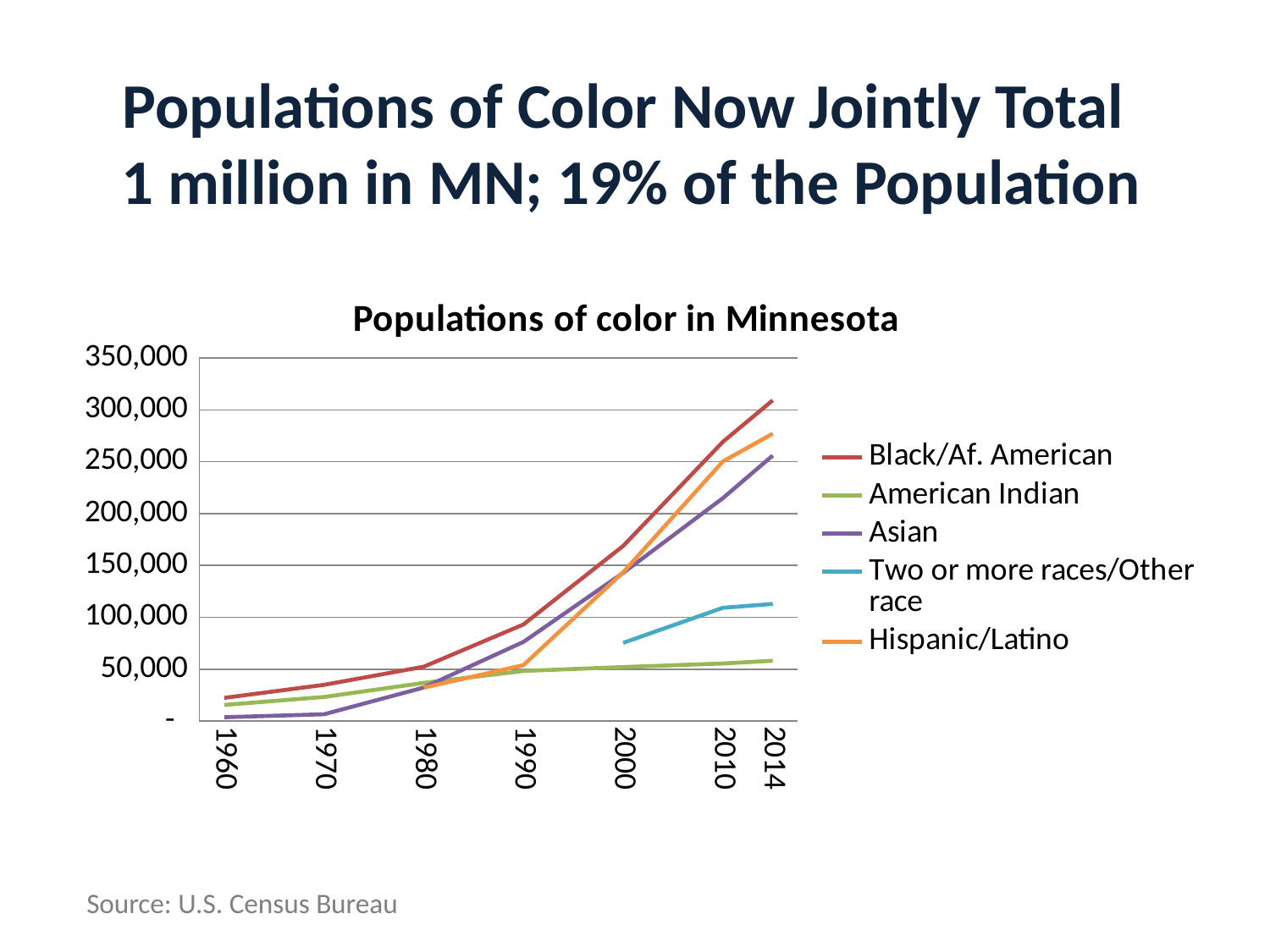
Is the value for American Indian in 2014 greater or less than 100,000? less Which series only begins at the year 2000? Two or more races/Other race Which population group has the highest value in 2014? Black/Af. American In 2014, which is larger: the Asian population or the Hispanic/Latino population? Hispanic/Latino Which population group has the lowest value in 2014? American Indian Does the Black/Af. American line rise or fall from 1960 to 2014? rise Is the value for Black/Af. American in 2014 greater or less than 250,000? greater Is the value for Asian in 2014 greater or less than 300,000? less How many years are shown on the x axis? 7 How many series does the legend list? 5 What kind of chart is shown on the slide? line chart